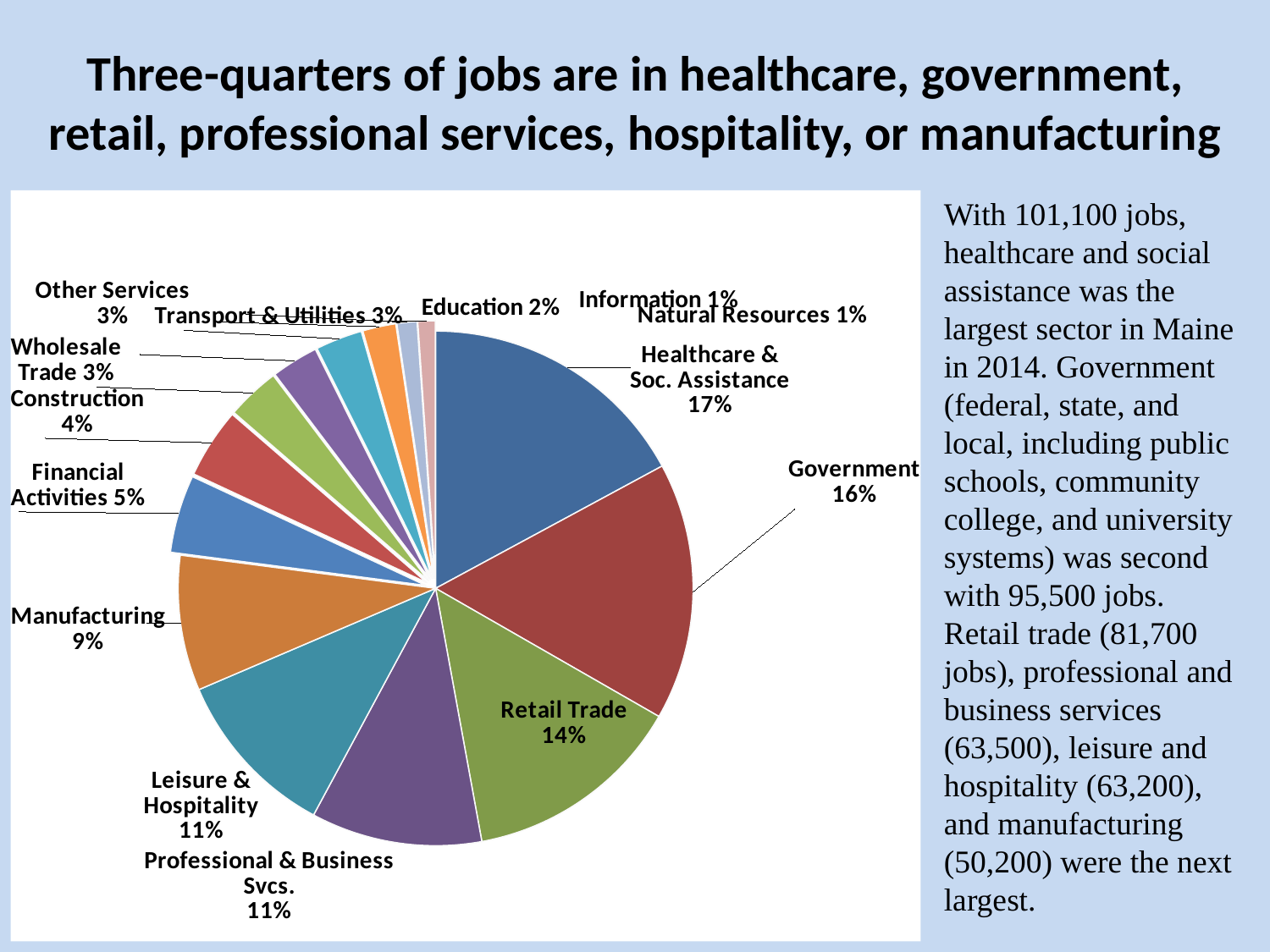
What share of jobs is in Healthcare & Soc. Assistance? 17% How many sectors are shown in the pie chart? 14 What share of jobs is in Retail Trade? 14% What is the combined share of Healthcare & Soc. Assistance and Government? 33% What share of jobs is in Manufacturing? 9% What is the title of the slide containing the pie chart? Three-quarters of jobs are in healthcare, government, retail, professional services, hospitality, or manufacturing Which sector has the largest share of jobs? Healthcare & Soc. Assistance What share of jobs is in Financial Activities? 5% What is the difference in percentage points between Healthcare & Soc. Assistance and Manufacturing? 8 What type of chart is shown on the slide? pie chart What share of jobs is in Government? 16% Which is larger, the share for Retail Trade or the share for Leisure & Hospitality? Retail Trade